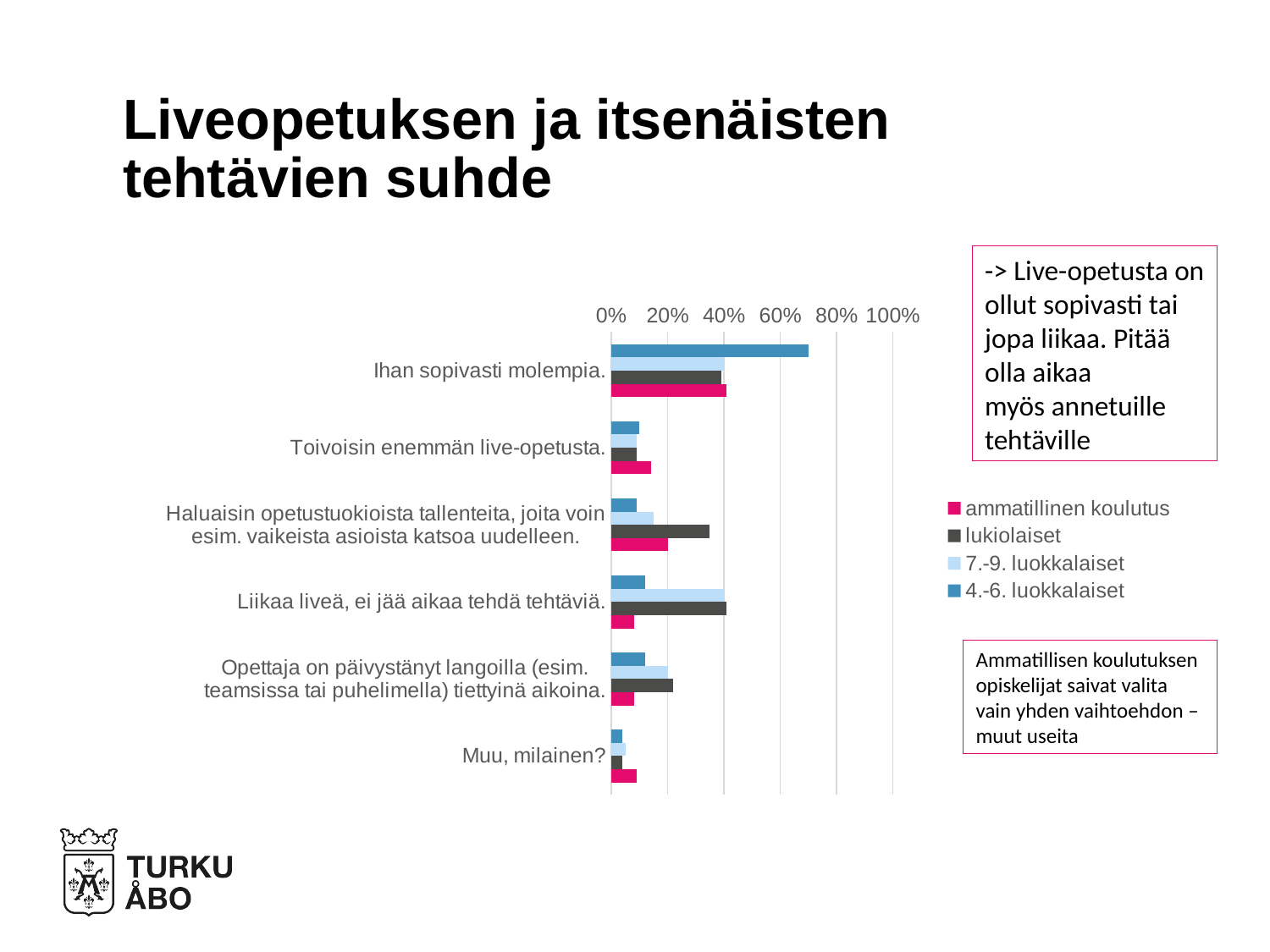
In the category "Liikaa liveä, ei jää aikaa tehdä tehtäviä.", which is larger: the value for lukiolaiset or for ammatillinen koulutus? lukiolaiset In the category "Haluaisin opetustuokioista tallenteita, joita voin esim. vaikeista asioista katsoa uudelleen.", which is larger: the value for lukiolaiset or for 4.-6. luokkalaiset? lukiolaiset Is the value for lukiolaiset in the category "Haluaisin opetustuokioista tallenteita, joita voin esim. vaikeista asioista katsoa uudelleen." greater or less than 40%? less Is the value for ammatillinen koulutus in the category "Toivoisin enemmän live-opetusta." greater or less than 20%? less For the series 4.-6. luokkalaiset, which category has the highest value? Ihan sopivasti molempia. For the series 4.-6. luokkalaiset, which category has the lowest value? Muu, milainen? What kind of chart is shown on the slide? bar chart How many series does the legend list? 4 Is the value for ammatillinen koulutus in the category "Muu, milainen?" greater or less than 20%? less Which series is shown in pink in the legend? ammatillinen koulutus How many categories (response options) does the chart show? 6